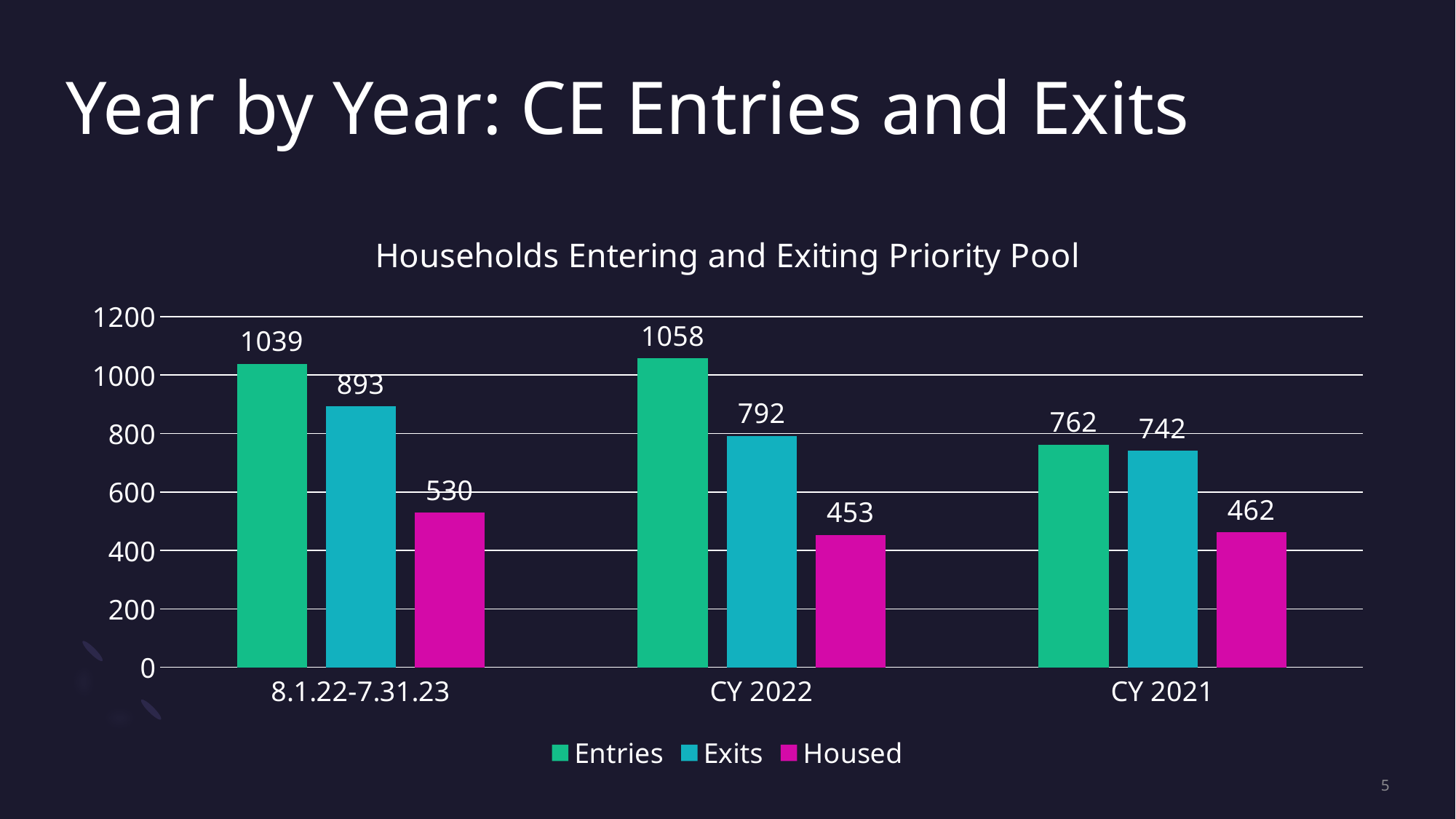
What is the value for Housed in the 8.1.22-7.31.23 period? 530 How many periods are shown on the x axis? 3 Which is larger in CY 2022: Exits or Housed? Exits How many series does the legend list? 3 What colour are the Housed bars? Magenta What is the title of the chart? Households Entering and Exiting Priority Pool Which period has the highest value for Entries? CY 2022 What is the value for Exits in CY 2021? 742 What is the value for Entries in CY 2022? 1058 What kind of chart is shown on the slide? Bar chart What is the difference between Entries and Exits in the 8.1.22-7.31.23 period? 146 Which period has the lowest value for Housed? CY 2022